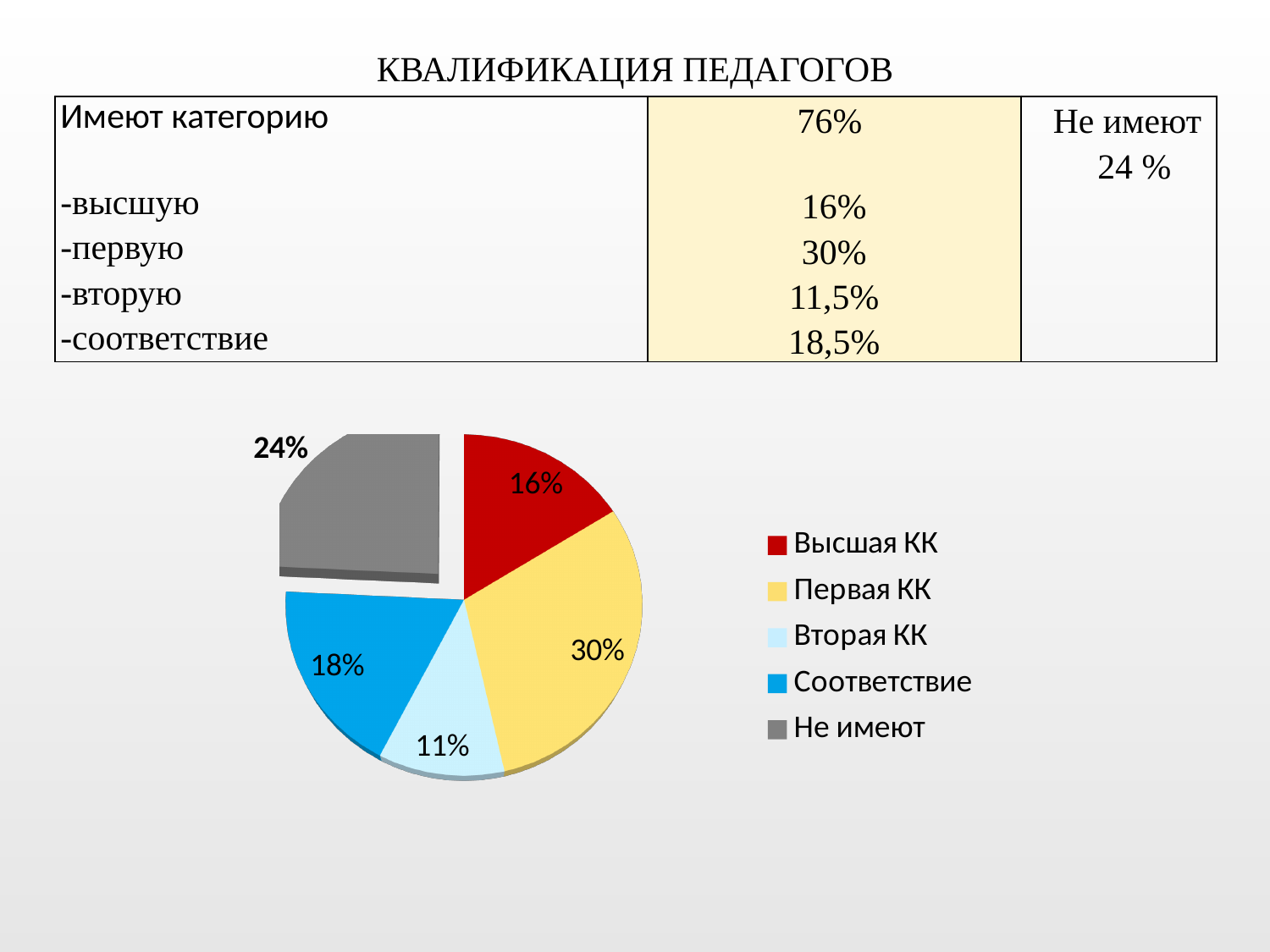
Which is larger in the pie chart, Соответствие or Не имеют? Не имеют What is the value shown for Первая КК in the pie chart? 30% Which slice of the pie chart is pulled out from the rest? Не имеют What kind of chart is shown on the slide? pie chart What is the difference between the Первая КК slice and the Высшая КК slice? 14% Which category has the smallest slice in the pie chart? Вторая КК How many slices does the pie chart have? 5 Which category has the largest slice in the pie chart? Первая КК What is the value shown for Соответствие in the pie chart? 18% What is the value shown for Высшая КК in the pie chart? 16% What is the value shown for Не имеют in the pie chart? 24% What is the value shown for Вторая КК in the pie chart? 11%